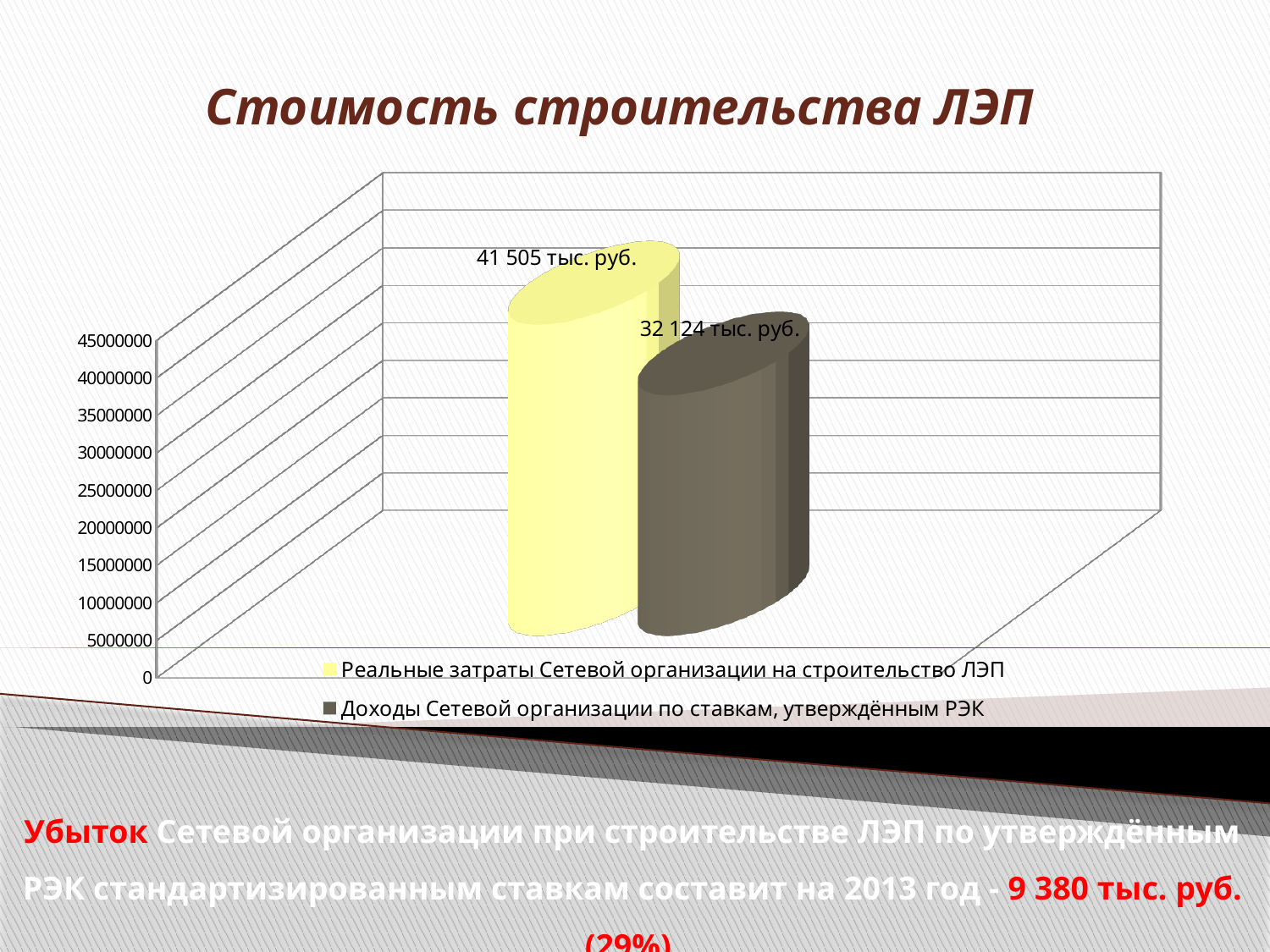
How many bars are plotted on the chart? 2 Is the value for "Доходы Сетевой организации по ставкам, утверждённым РЭК" greater or less than 35000000 on the axis? less What kind of chart is shown on the slide? bar chart What colour is the bar for "Реальные затраты Сетевой организации на строительство ЛЭП"? yellow Which is larger: the real costs of the network organisation or its income at the rates approved by РЭК? Реальные затраты Сетевой организации на строительство ЛЭП What value is shown for the series "Доходы Сетевой организации по ставкам, утверждённым РЭК"? 32 124 тыс. руб. Is the value for "Реальные затраты Сетевой организации на строительство ЛЭП" greater or less than 40000000 on the axis? greater How many series does the legend list? 2 Which series has the higher value? Реальные затраты Сетевой организации на строительство ЛЭП What value is shown for the series "Реальные затраты Сетевой организации на строительство ЛЭП"? 41 505 тыс. руб. What is the title of the chart on the slide? Стоимость строительства ЛЭП Which series has the lower value? Доходы Сетевой организации по ставкам, утверждённым РЭК